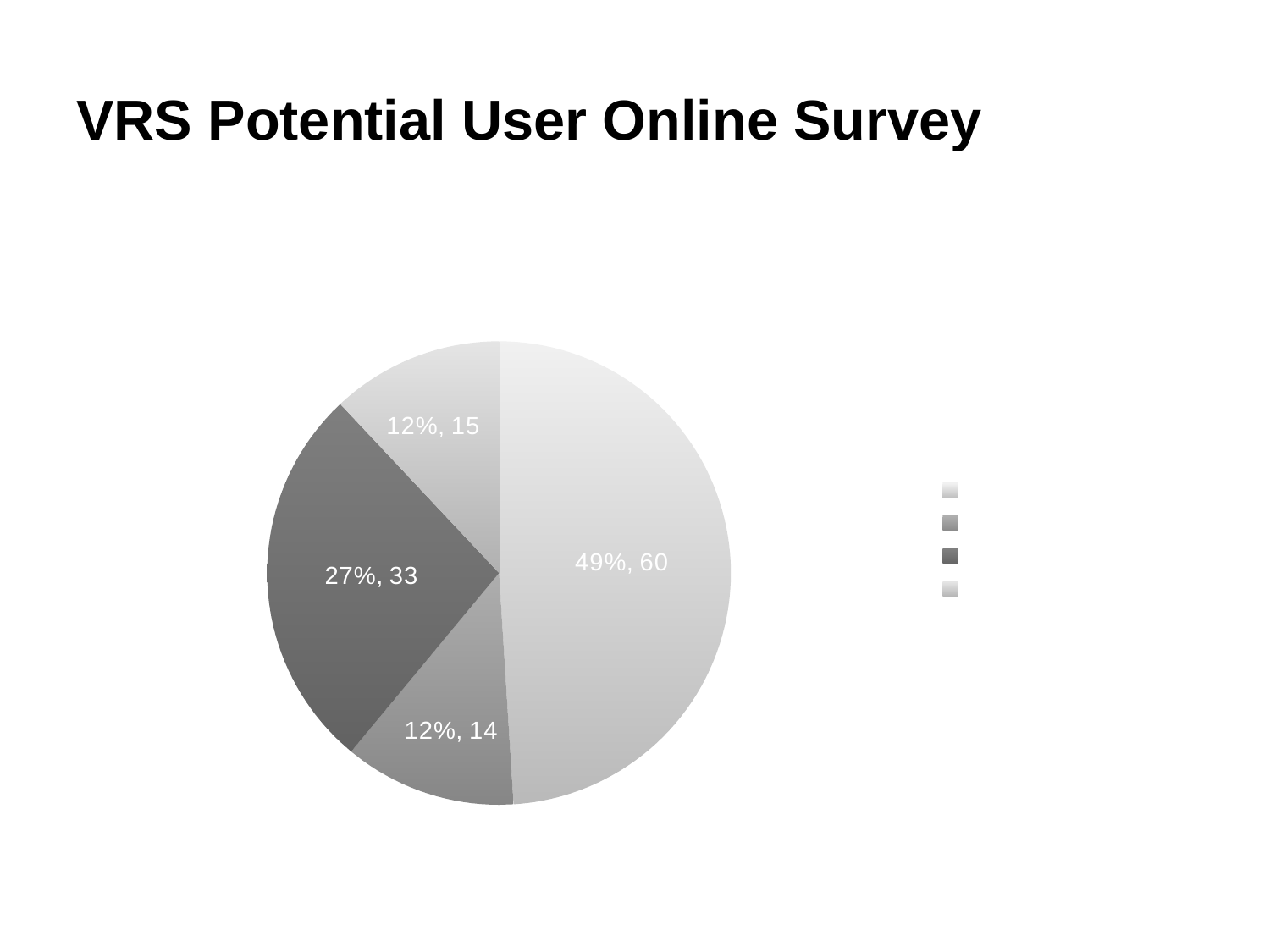
What is the total of all four slice values in the pie chart? 122 What is the value of the largest slice of the pie chart? 60 What percentage share does the largest slice of the pie chart have? 49% What is the value of the smallest slice of the pie chart? 14 What is the value of the slice labelled 27% in the pie chart? 33 Which is larger in the pie chart: the slice with value 15 or the slice with value 14? the slice with value 15 What kind of chart is shown on the slide? pie chart How many slices does the pie chart have? 4 What percentage share does the slice with value 33 have in the pie chart? 27% How many entries does the legend of the pie chart list? 4 What is the title of the slide containing the pie chart? VRS Potential User Online Survey What is the difference between the largest slice (60) and the second-largest slice (33) in the pie chart? 27